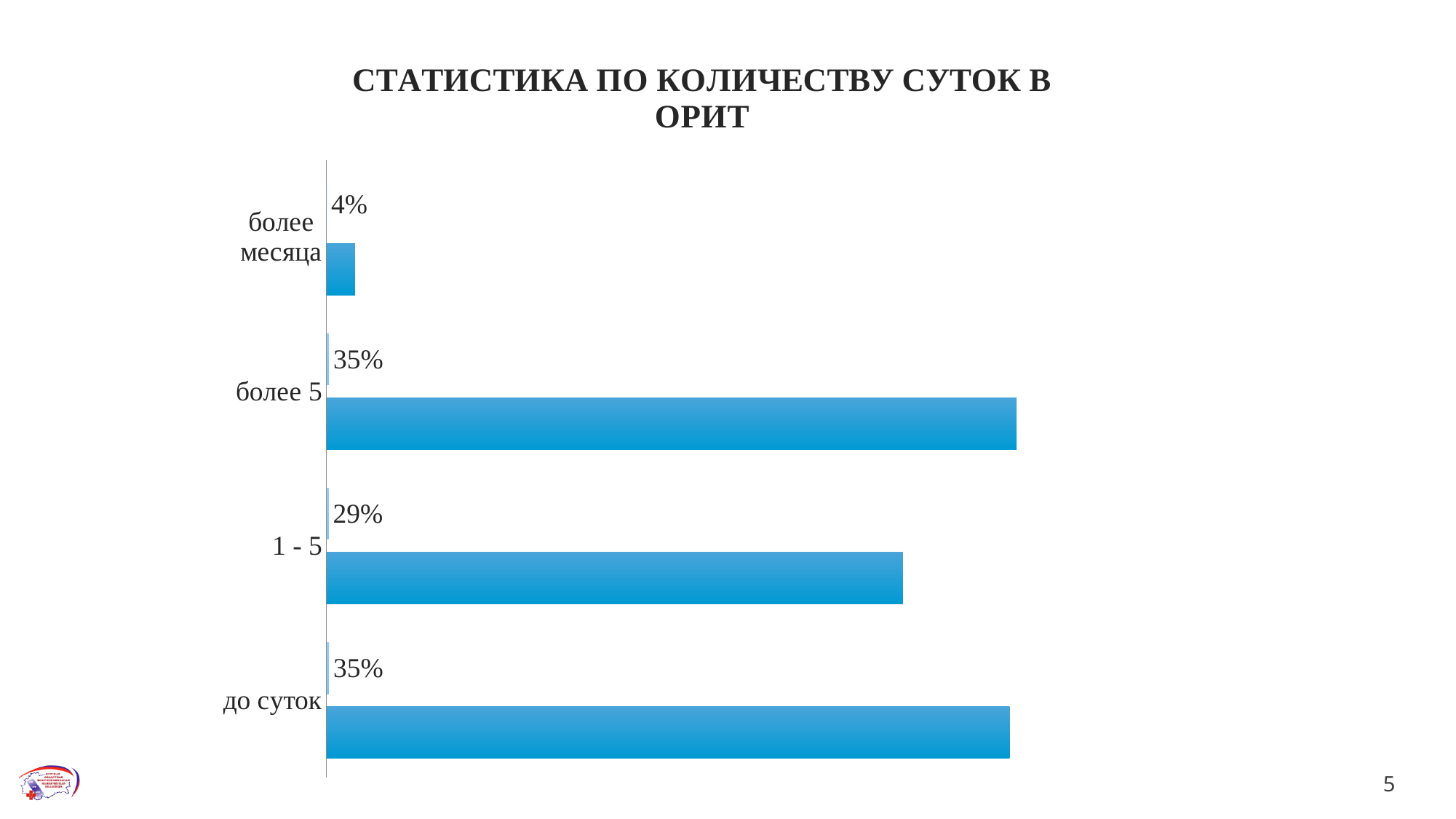
What is the difference between the values for "более 5" and "более месяца"? 31% What is the value for the category "более месяца"? 4% How many categories are shown in the chart? 4 What is the title of the chart? СТАТИСТИКА ПО КОЛИЧЕСТВУ СУТОК В ОРИТ What is the value for the category "более 5"? 35% Which category has the lowest value? более месяца What is the value for the category "1 - 5"? 29% Which is larger, the value for "более 5" or the value for "1 - 5"? более 5 Which is larger, the value for "1 - 5" or the value for "более месяца"? 1 - 5 What is the value for the category "до суток"? 35% What kind of chart is shown on the slide? bar chart What is the difference between the values for "до суток" and "1 - 5"? 6%